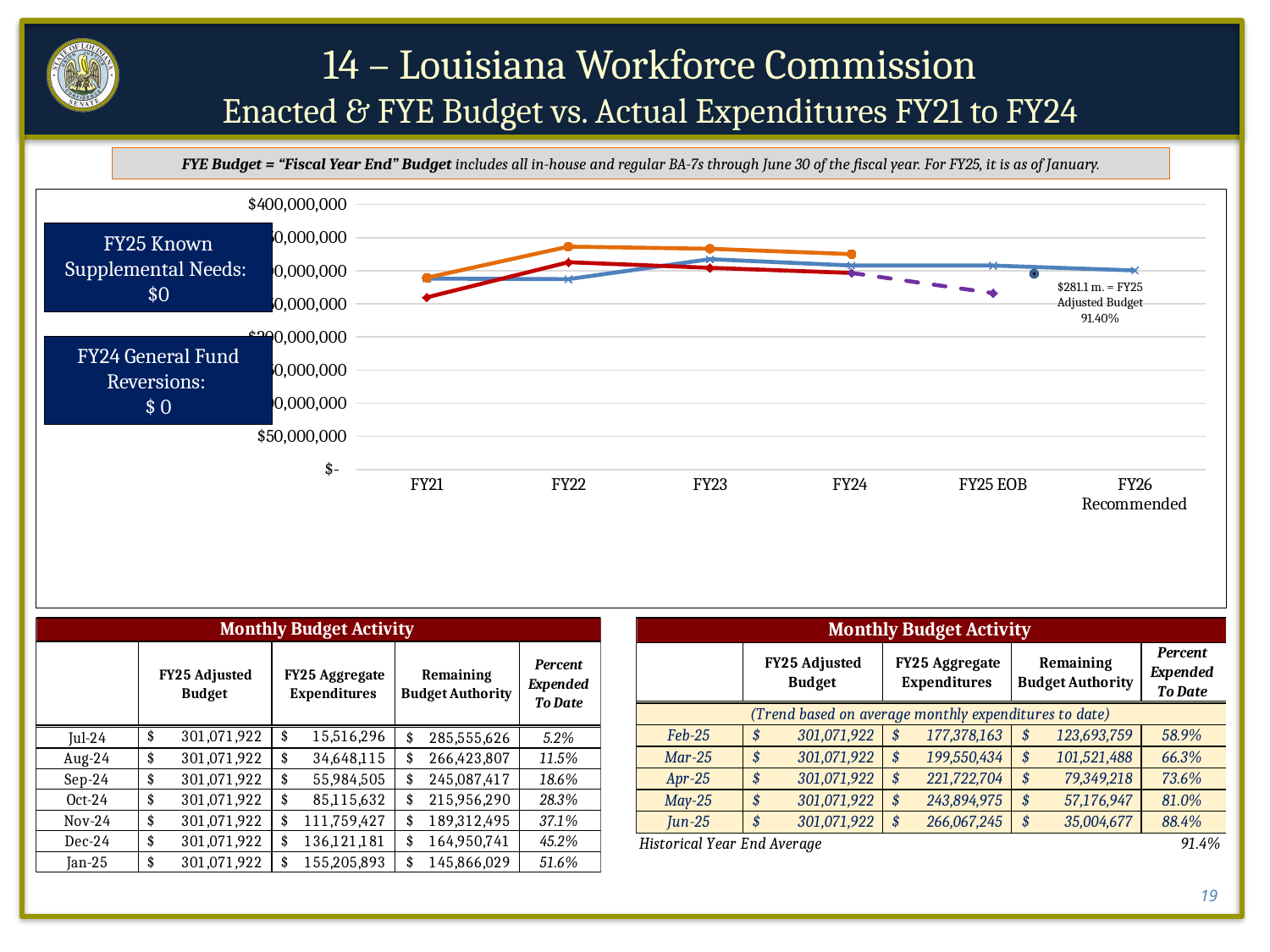
At which fiscal year is the red line at its lowest point? FY21 What kind of chart is shown on the slide? line chart Is the value of the red line at FY21 greater or less than $300,000,000? less Is the value of the orange line at FY22 greater or less than $300,000,000? greater What is the last category label on the x axis of the chart? FY26 Recommended Is the value of the purple dashed line at FY25 EOB greater or less than $300,000,000? less What is the highest value shown on the y axis of the chart? $400,000,000 According to the data label on the chart, what is the FY25 Adjusted Budget? $281.1 m. Does the red line rise or fall from FY21 to FY22? rise At which fiscal year does the orange line reach its highest point? FY22 What percentage is shown in the data label next to the FY25 Adjusted Budget on the chart? 91.40% How many fiscal-year categories are shown along the x axis of the chart? 6